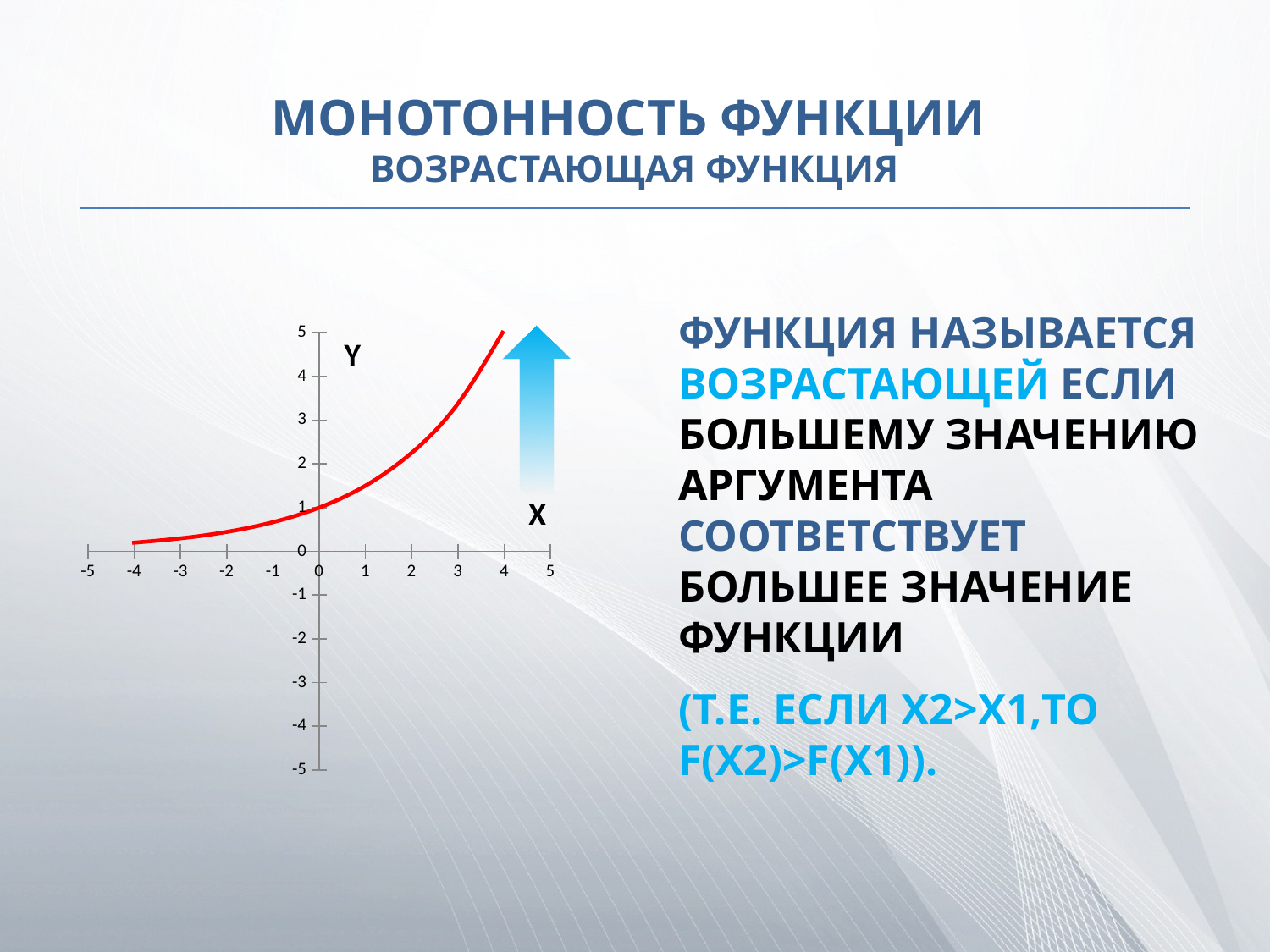
What kind of chart is shown on the slide? line chart Is the value of the curve at x = -4 greater or less than 1? less At which labelled x value does the curve reach its highest point? 4 Is the value of the curve at x = 2 greater or less than 4? less What is the range of values labelled on the x axis? -5 to 5 Is the value of the curve at x = 0 greater or less than 2? less What colour is the plotted curve? red At which labelled x value does the curve reach its lowest point? -4 Does the plotted curve rise or fall as x increases from left to right? rises Which is larger: the value of the curve at x = 4 or at x = -4? x = 4